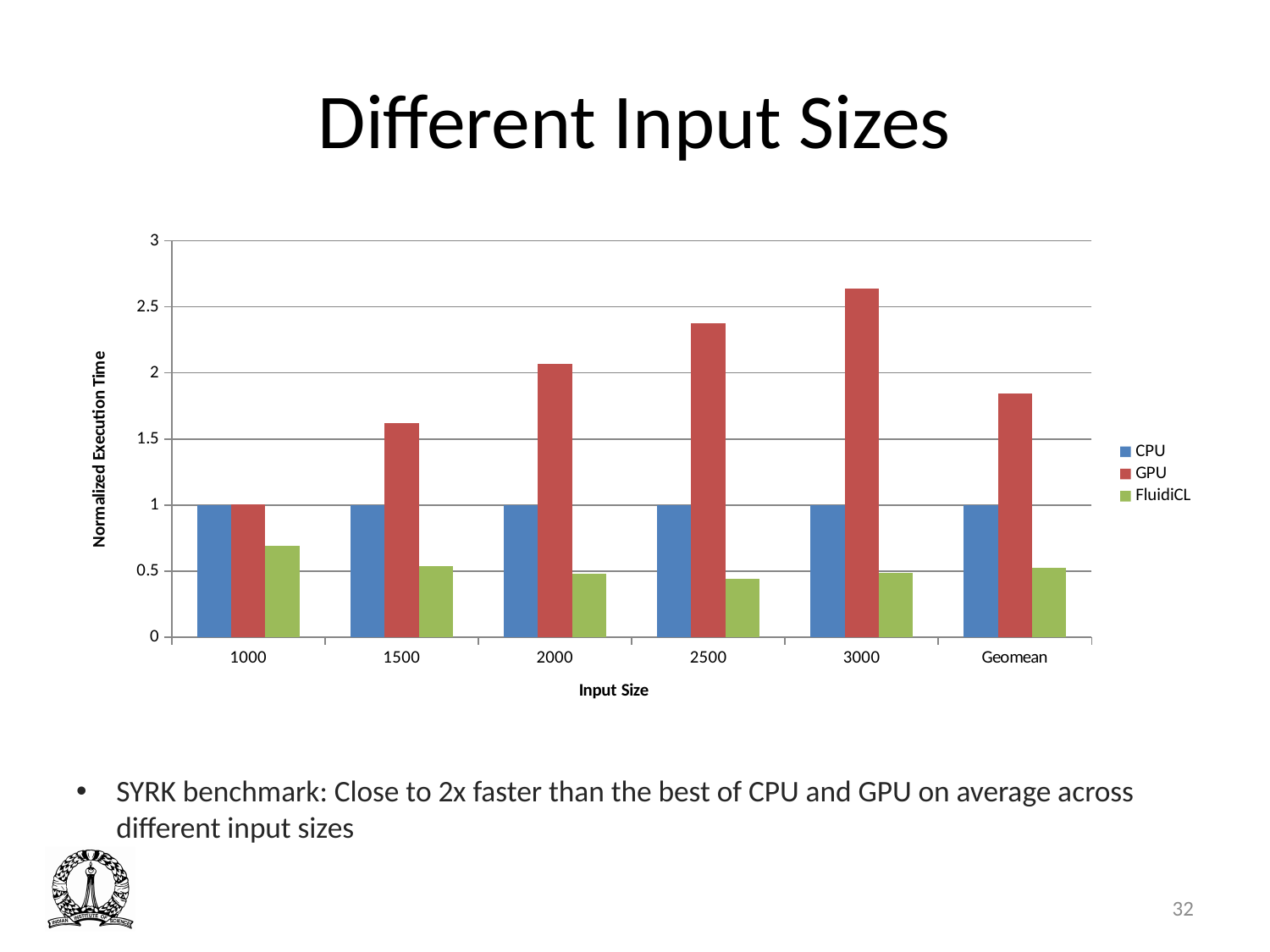
Do the GPU values rise or fall as the input size increases from 1000 to 3000? rise What is the title of the y axis? Normalized Execution Time Is the GPU value for Geomean greater or less than 2? less Is the FluidiCL value at input size 2500 greater or less than 0.5? less Which is larger at input size 1500, the GPU bar or the FluidiCL bar? GPU Is the GPU value at input size 3000 greater or less than 2.5? greater How many input size categories are shown on the x axis? 6 How many series does the legend list? 3 At which input size is the GPU bar the highest? 3000 What is the normalized execution time for CPU at input size 2000? 1 What kind of chart is shown on the slide? bar chart